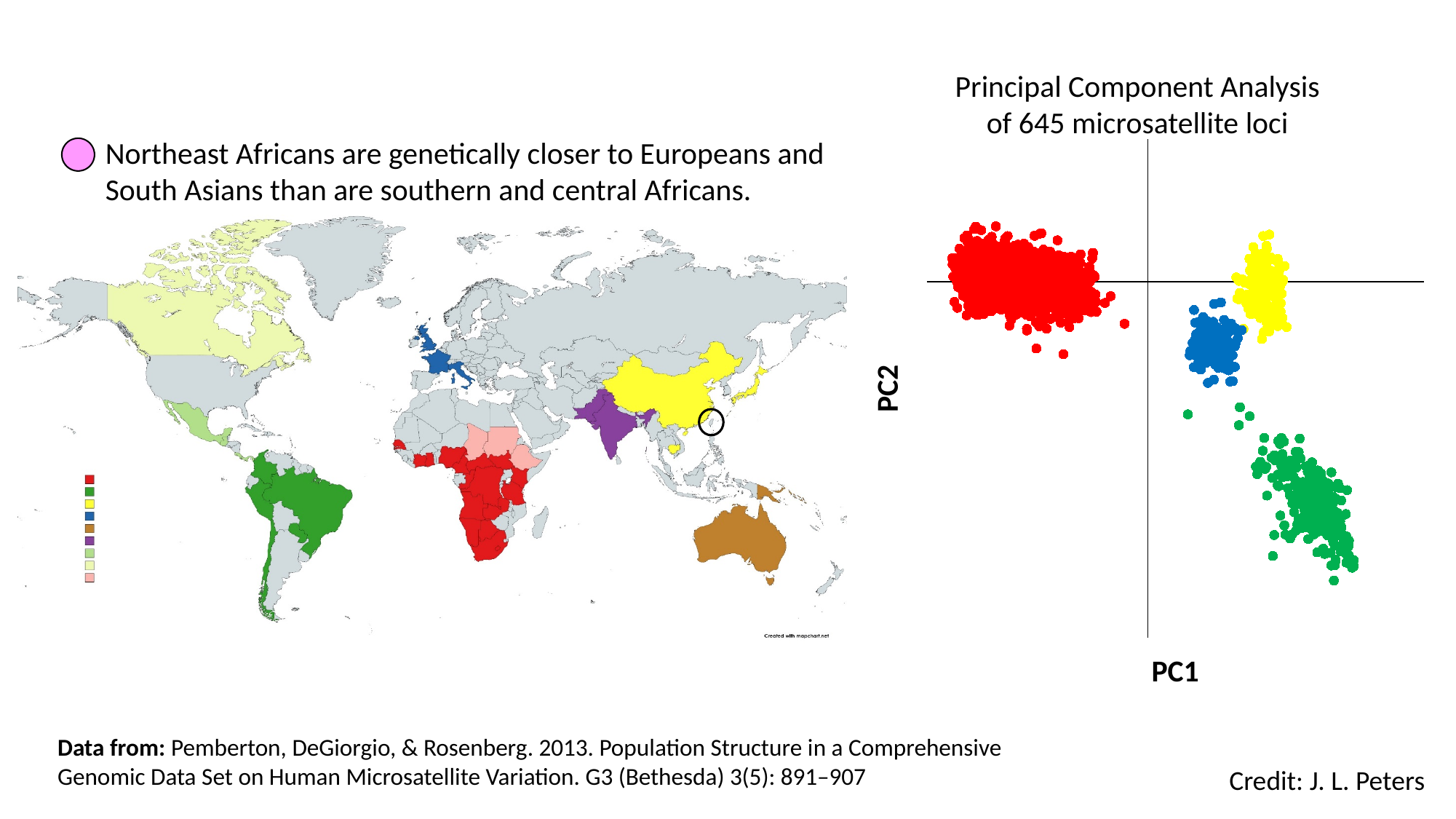
What is the title of the chart on the right of the slide? Principal Component Analysis of 645 microsatellite loci In the Principal Component Analysis chart, which cluster has higher PC2 values, the red cluster or the blue cluster? Red In the Principal Component Analysis chart, which cluster has higher PC2 values, the yellow cluster or the green cluster? Yellow In the Principal Component Analysis chart, which cluster has higher PC1 values, the red cluster or the yellow cluster? Yellow How many distinct coloured clusters of points are shown in the Principal Component Analysis chart? 4 In the Principal Component Analysis chart, which coloured cluster lies furthest to the left along PC1? Red In the Principal Component Analysis chart, what are the labels of the horizontal and vertical axes? PC1 and PC2 What kind of chart is the Principal Component Analysis chart on the right of the slide? Scatter plot In the Principal Component Analysis chart, which coloured cluster lies furthest to the right along PC1? Green In the Principal Component Analysis chart, which coloured cluster lies lowest along PC2? Green